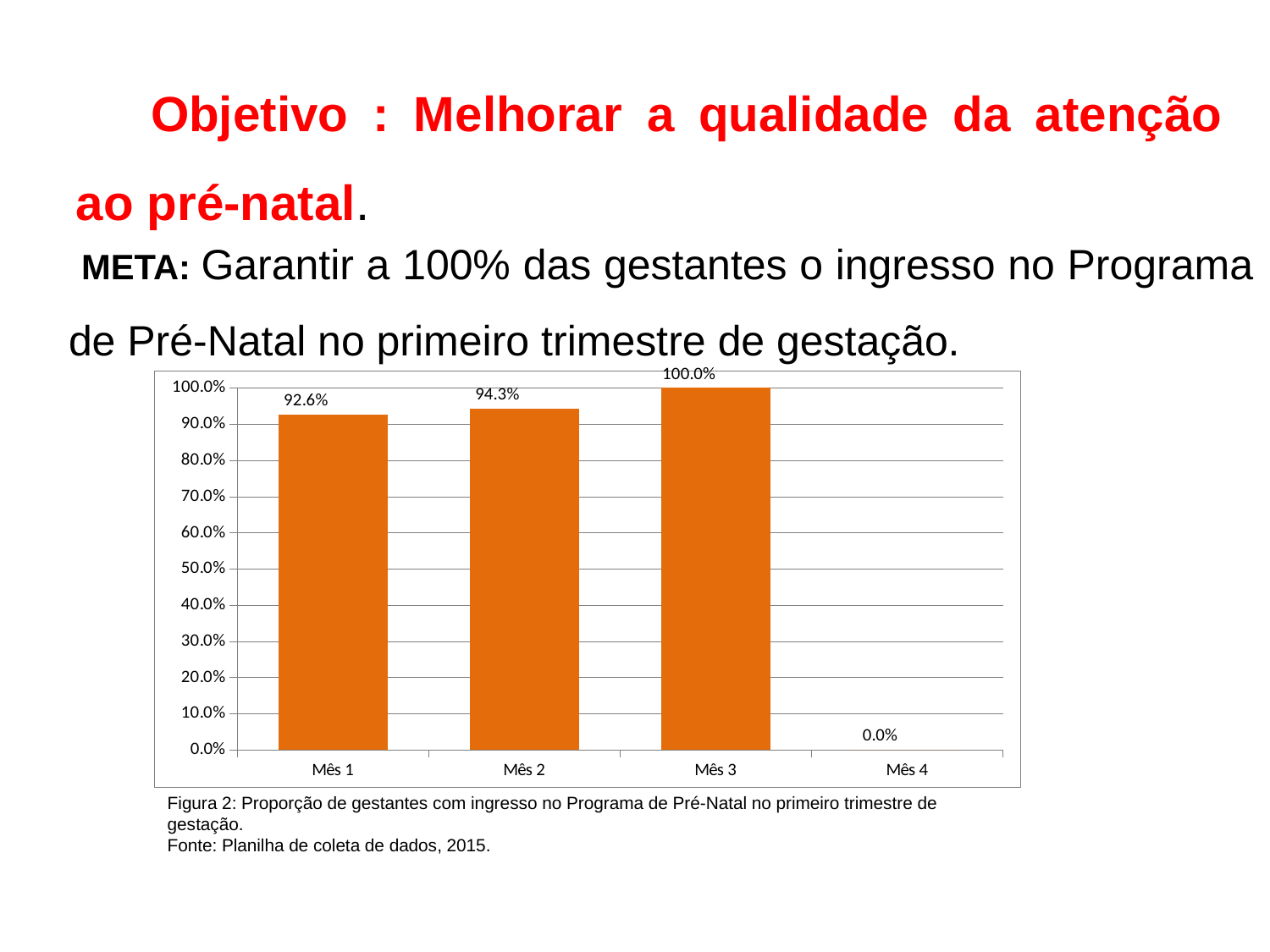
What is the value for Mês 1? 92.6% What colour are the bars in the chart? Orange What is the value for Mês 4? 0.0% Which is larger, the value for Mês 1 or the value for Mês 2? Mês 2 What is the difference between the values for Mês 2 and Mês 1? 1.7% What is the value for Mês 3? 100.0% What is the value for Mês 2? 94.3% How many months are shown on the x axis? 4 Which month has the lowest value? Mês 4 What is the difference between the values for Mês 3 and Mês 1? 7.4% What kind of chart is shown on the slide? Bar chart Which month has the highest value? Mês 3